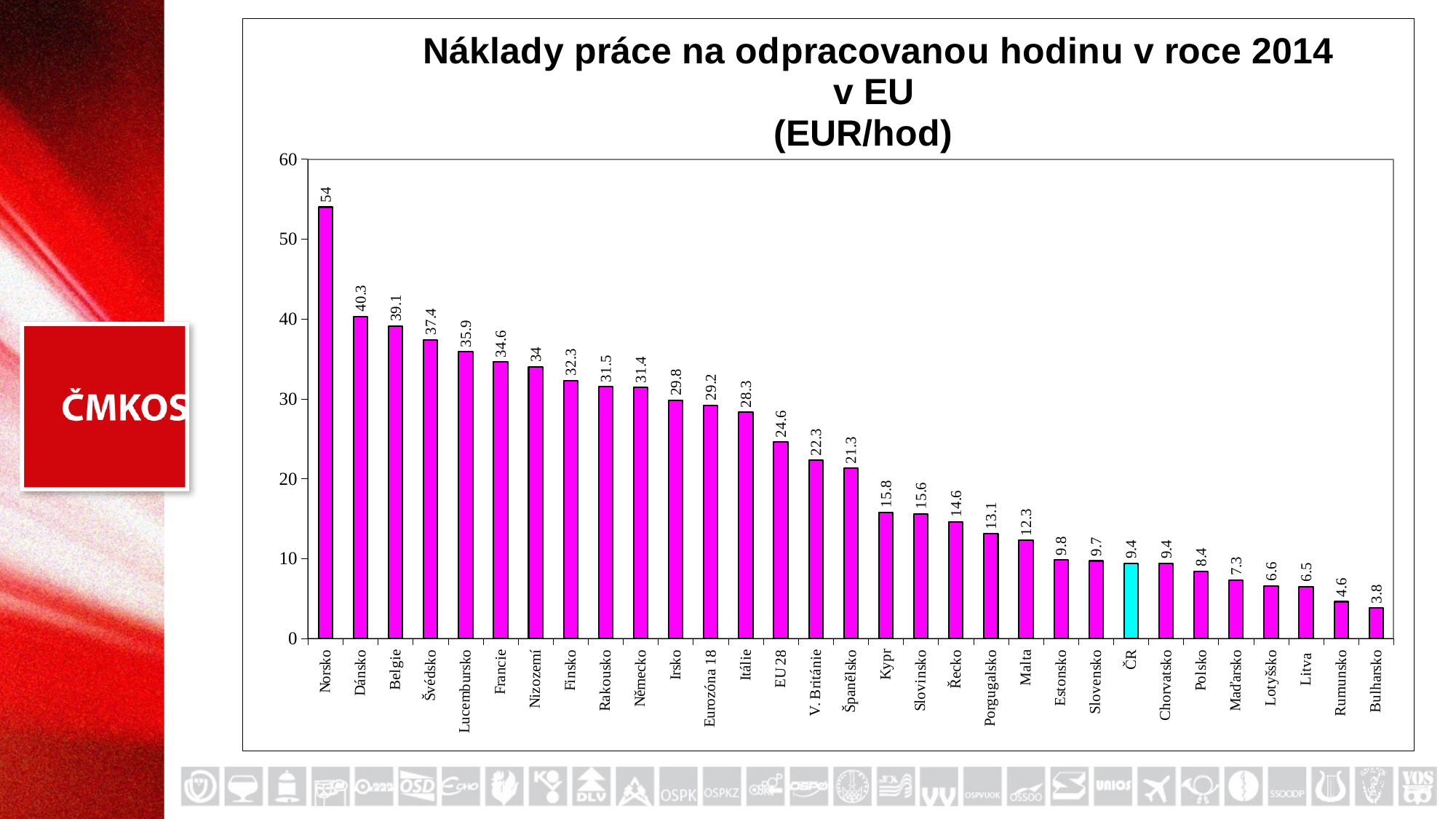
What is the difference between the values for EU 28 and ČR? 15.2 What kind of chart is shown on the slide? bar chart How many countries or regions are shown on the x axis? 31 Which bar is coloured differently (cyan) from the others? ČR What is the value for ČR? 9.4 Which is larger, the value for Francie or the value for Finsko? Francie Is the value for Španělsko greater or less than 20? greater Which country has the lowest labour cost per hour? Bulharsko Which country has the highest labour cost per hour? Norsko What is the value for EU 28? 24.6 What is the difference between the values for Norsko and Dánsko? 13.7 What is the value for Německo? 31.4